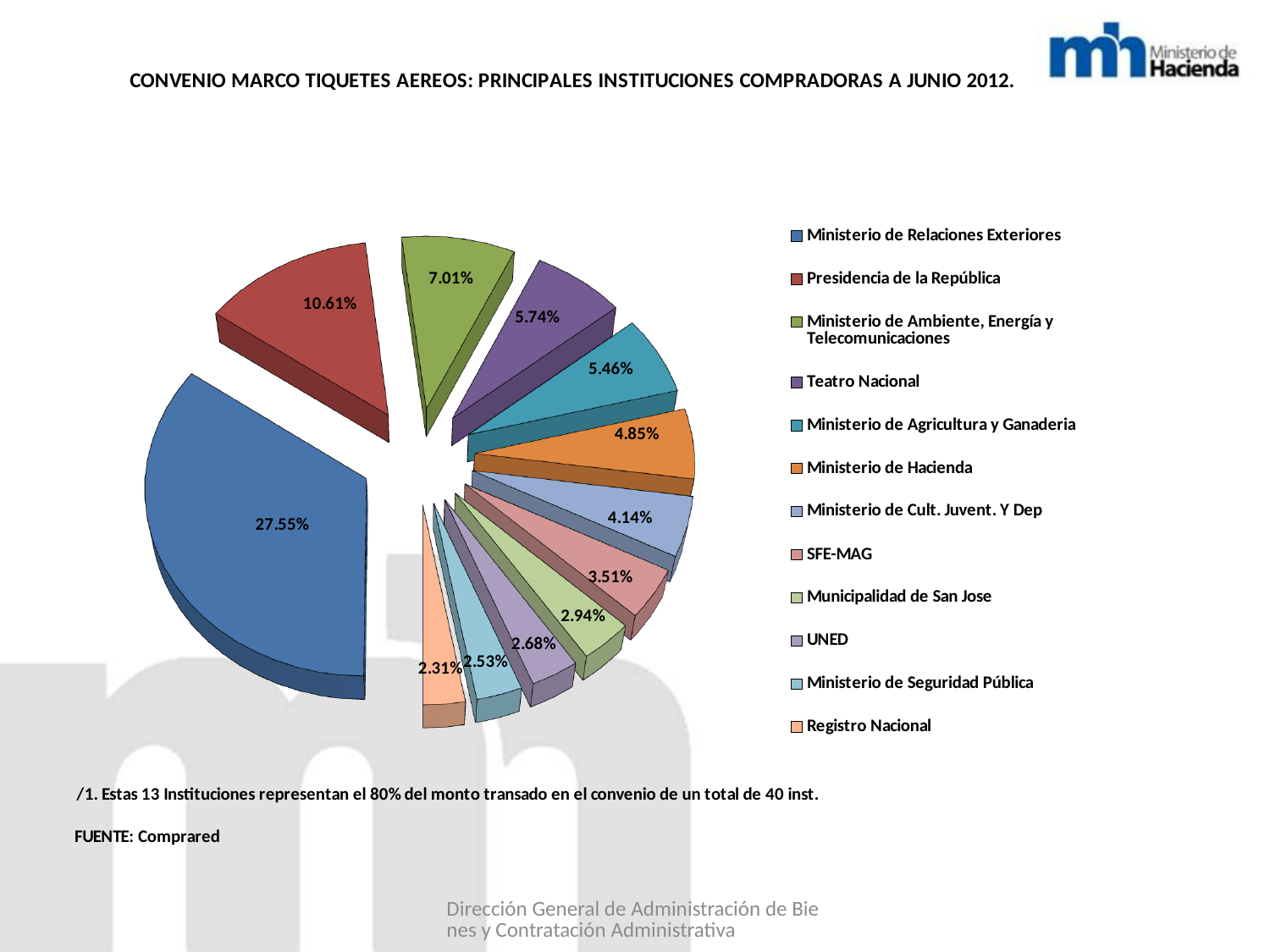
What is the difference between the shares of Ministerio de Relaciones Exteriores and Presidencia de la República? 16.94% What share of the pie does Ministerio de Relaciones Exteriores have? 27.55% What kind of chart is shown on the slide? pie chart What is the title of the chart? CONVENIO MARCO TIQUETES AEREOS: PRINCIPALES INSTITUCIONES COMPRADORAS A JUNIO 2012. Which institution has the largest slice of the pie? Ministerio de Relaciones Exteriores What is the value for Registro Nacional? 2.31% How many institutions does the legend list? 12 Which institution has the smallest slice of the pie? Registro Nacional Which has a larger share, Teatro Nacional or Ministerio de Agricultura y Ganaderia? Teatro Nacional Which has a larger share, SFE-MAG or Municipalidad de San Jose? SFE-MAG What percentage is shown for Ministerio de Hacienda? 4.85% What is the value shown for Presidencia de la República? 10.61%